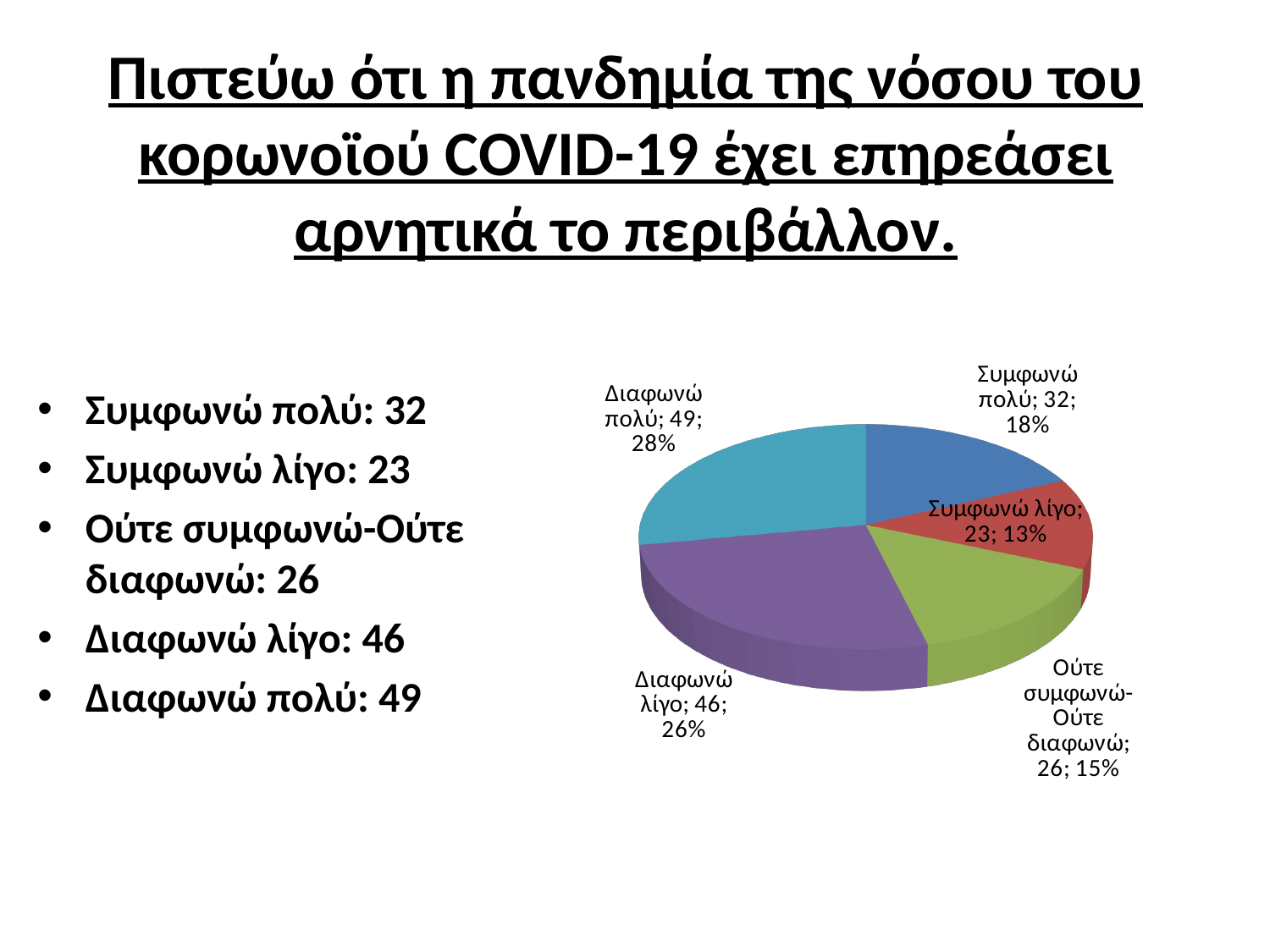
How many slices does the pie chart have? 5 What colour is the Διαφωνώ λίγο slice in the pie chart? purple What kind of chart is shown on the slide? pie chart What is the value for Διαφωνώ πολύ in the pie chart? 49 What percentage share does Συμφωνώ πολύ have in the pie chart? 18% What percentage share does Συμφωνώ λίγο have in the pie chart? 13% Which category has the smallest slice in the pie chart? Συμφωνώ λίγο Which category has the largest slice in the pie chart? Διαφωνώ πολύ What percentage share does Διαφωνώ λίγο have in the pie chart? 26% What is the value for Ούτε συμφωνώ-Ούτε διαφωνώ in the pie chart? 26 What is the difference between the values for Διαφωνώ πολύ and Συμφωνώ πολύ? 17 Which is larger: the value for Ούτε συμφωνώ-Ούτε διαφωνώ or the value for Συμφωνώ λίγο? Ούτε συμφωνώ-Ούτε διαφωνώ